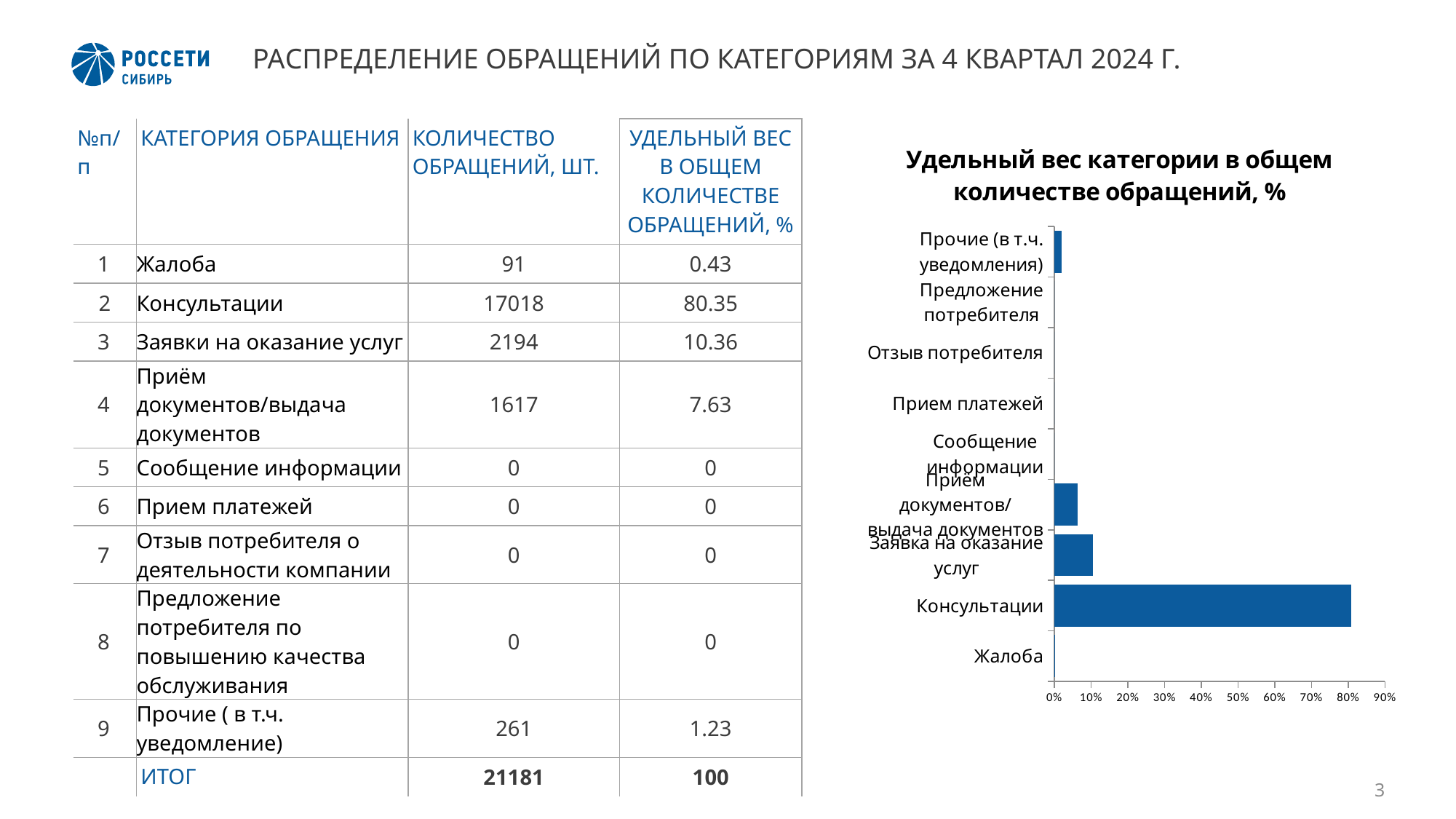
Is the value for Приём документов/выдача документов greater or less than 10%? less Is the value for Консультации greater or less than 70%? greater Which is larger in the chart, Консультации or Прочие (в т.ч. уведомления)? Консультации Is the value for Заявка на оказание услуг greater or less than 20%? less What is the highest percentage tick shown on the chart's horizontal axis? 90% Which is larger in the chart, Заявка на оказание услуг or Приём документов/выдача документов? Заявка на оказание услуг According to the table, what share of all requests does Заявки на оказание услуг account for? 10.36 According to the table, what share of all requests does Консультации account for? 80.35 What is the title of the chart? Удельный вес категории в общем количестве обращений, % What kind of chart is shown on the slide? bar chart How many categories are plotted in the chart? 9 Which category has the highest value in the chart? Консультации